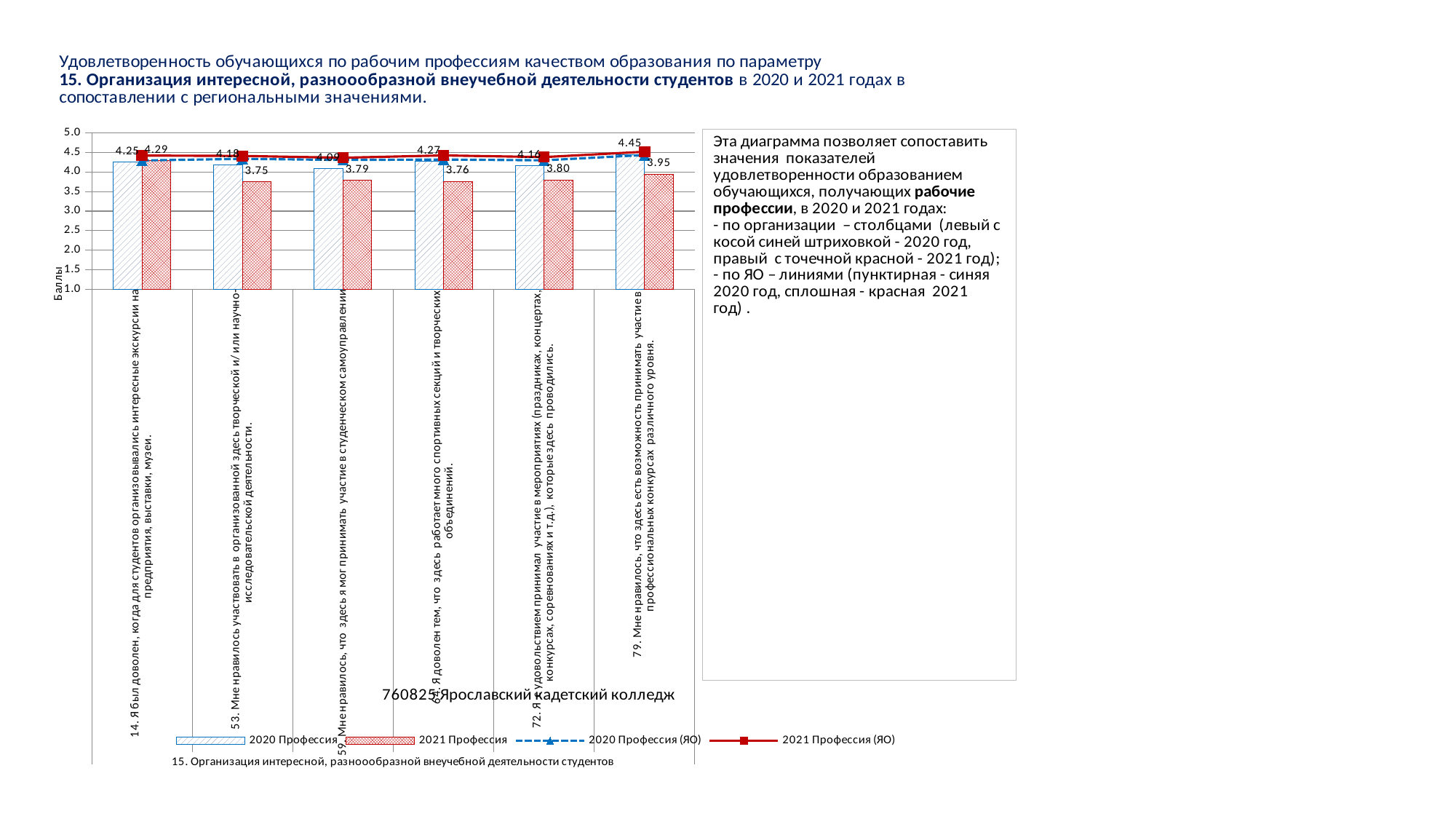
Which category has the highest 2021 Профессия bar? 14 What is the difference between the 2020 Профессия and 2021 Профессия bars for category 79? 0.50 Which category has the lowest 2021 Профессия bar? 53 Which category has the highest 2020 Профессия bar? 79 What is the value of the 2021 Профессия bar for category 53 (Мне нравилось участвовать в организованной здесь творческой и/или научно-исследовательской деятельности)? 3.75 How many series does the chart legend list? 4 How many categories (questions) are shown on the x axis of the chart? 6 What is the value of the 2020 Профессия bar for category 14 (Я был доволен, когда для студентов организовывались интересные экскурсии...)? 4.25 What is the value of the 2021 Профессия bar for category 14? 4.29 For category 53, which bar is larger: 2020 Профессия or 2021 Профессия? 2020 Профессия What is the value of the 2020 Профессия bar for category 79 (Мне нравилось, что здесь есть возможность принимать участие в профессиональных конкурсах различного уровня)? 4.45